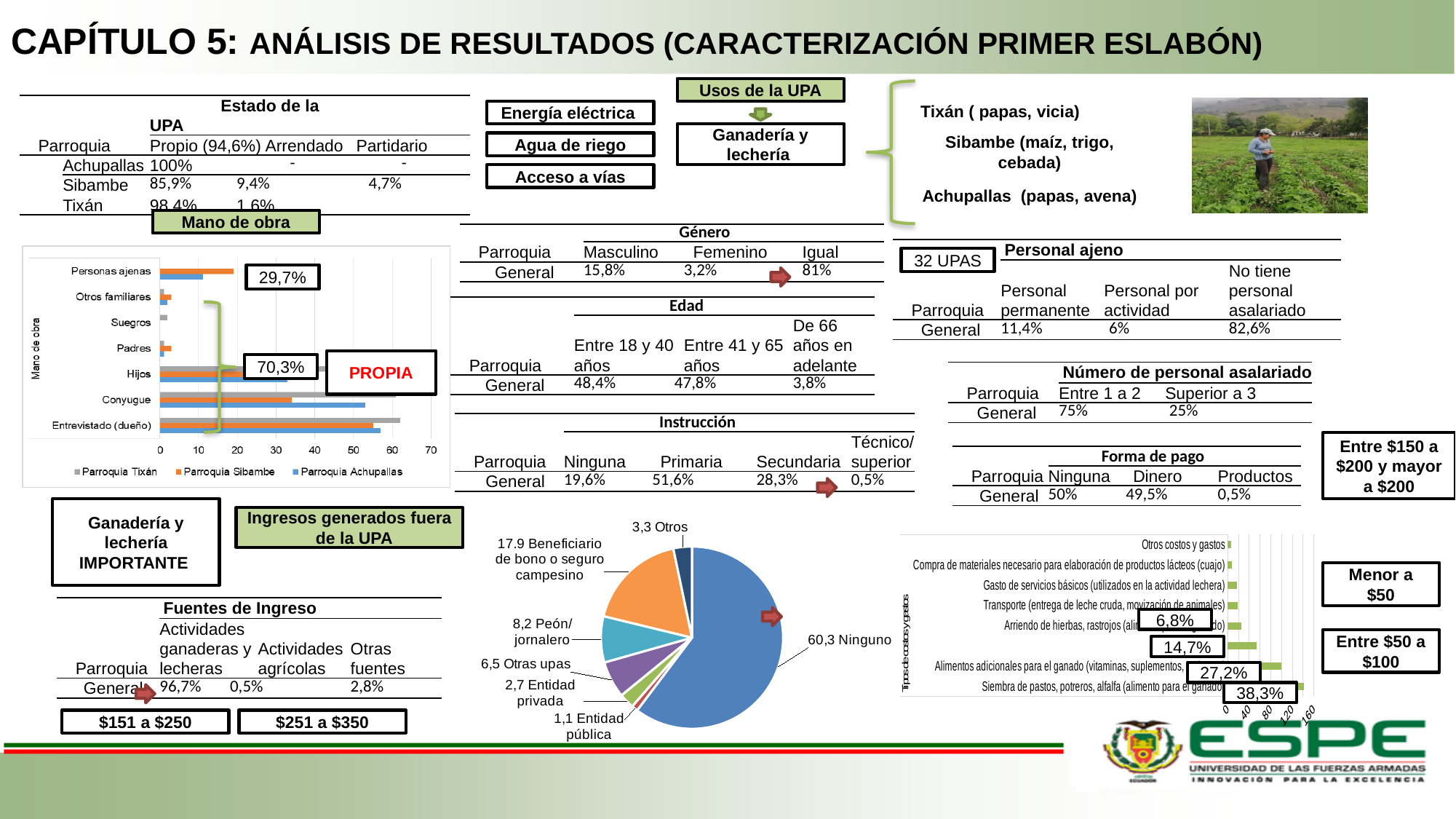
What type of chart is the 'Mano de obra' chart on the left of the slide? bar chart In the 'Mano de obra' bar chart, is the value for Entrevistado (dueño) in Parroquia Achupallas greater or less than 50? greater In the 'Mano de obra' bar chart, is the value for Suegros in Parroquia Tixán greater or less than 10? less How many categories are shown on the 'Mano de obra' bar chart? 7 In the pie chart at the bottom centre, what is the value for 'Ninguno'? 60,3 In the pie chart at the bottom centre, which slice is the smallest? Entidad pública In the pie chart at the bottom centre, what is the difference between 'Peón/jornalero' and 'Otras upas'? 1,7 In the bar chart at the bottom right of the slide, is the value for 'Siembra de pastos, potreros, alfalfa' greater or less than 120? greater In the 'Mano de obra' bar chart, which category has the highest values across the parroquias? Entrevistado (dueño) What type of chart is the one at the bottom centre of the slide showing 'Ninguno' and 'Otros'? pie chart In the pie chart at the bottom centre, what is the value for 'Peón/jornalero'? 8,2 How many series does the legend of the 'Mano de obra' bar chart list? 3